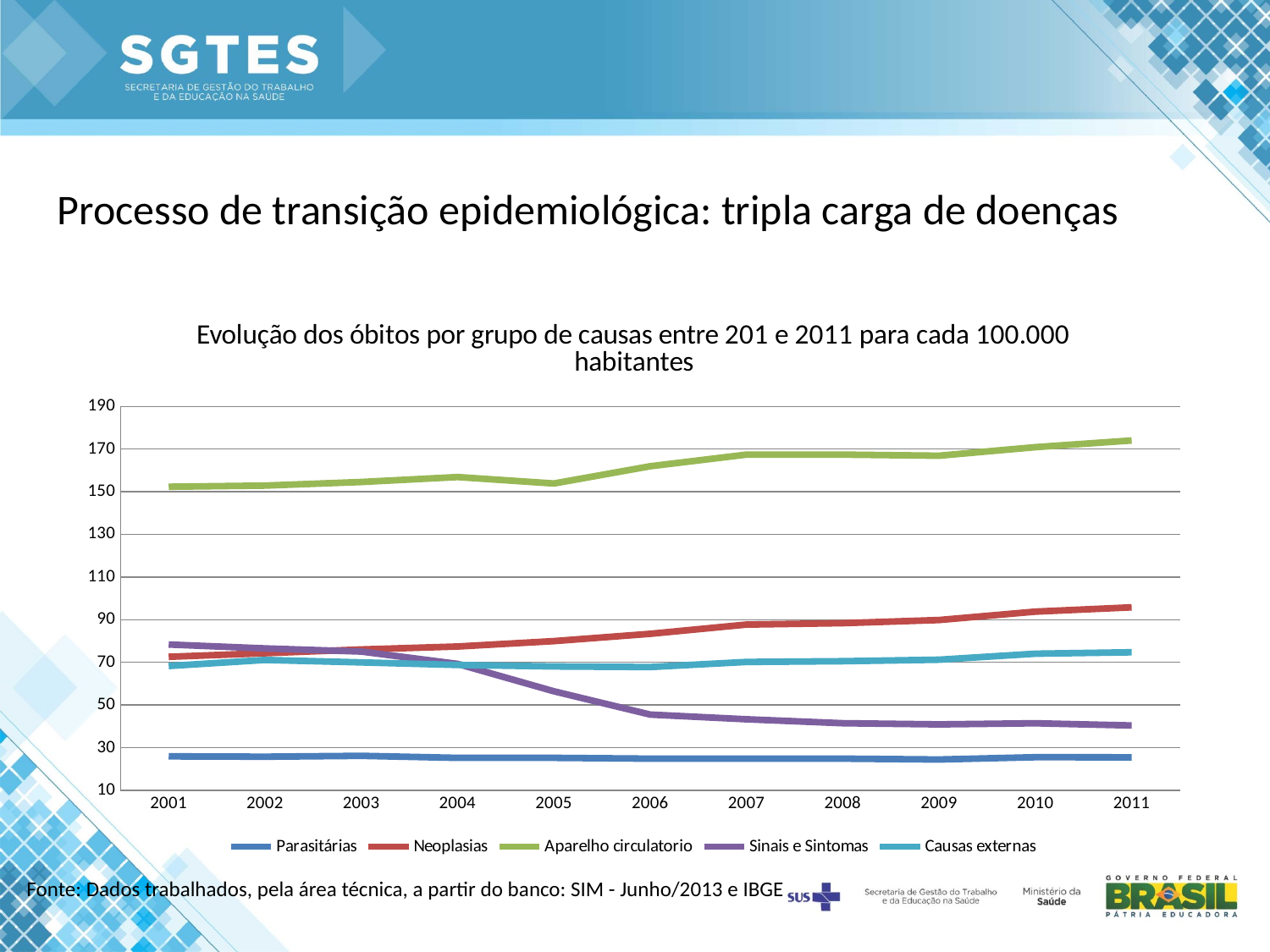
What kind of chart is shown on the slide? Line chart Which series has the lowest values across the whole period? Parasitárias Is the value for Aparelho circulatorio in 2011 greater or less than 170? greater In 2011, which is larger: Neoplasias or Causas externas? Neoplasias How many years are shown along the x axis? 11 Is the value for Sinais e Sintomas in 2011 greater or less than 50? less What colour is the line for Aparelho circulatorio? Green Does the Neoplasias series rise or fall from 2001 to 2011? Rise Is the value for Parasitárias in 2001 greater or less than 30? less Does the Sinais e Sintomas series rise or fall from 2001 to 2011? Fall How many series does the legend list? 5 Which series has the highest values across the whole period? Aparelho circulatorio